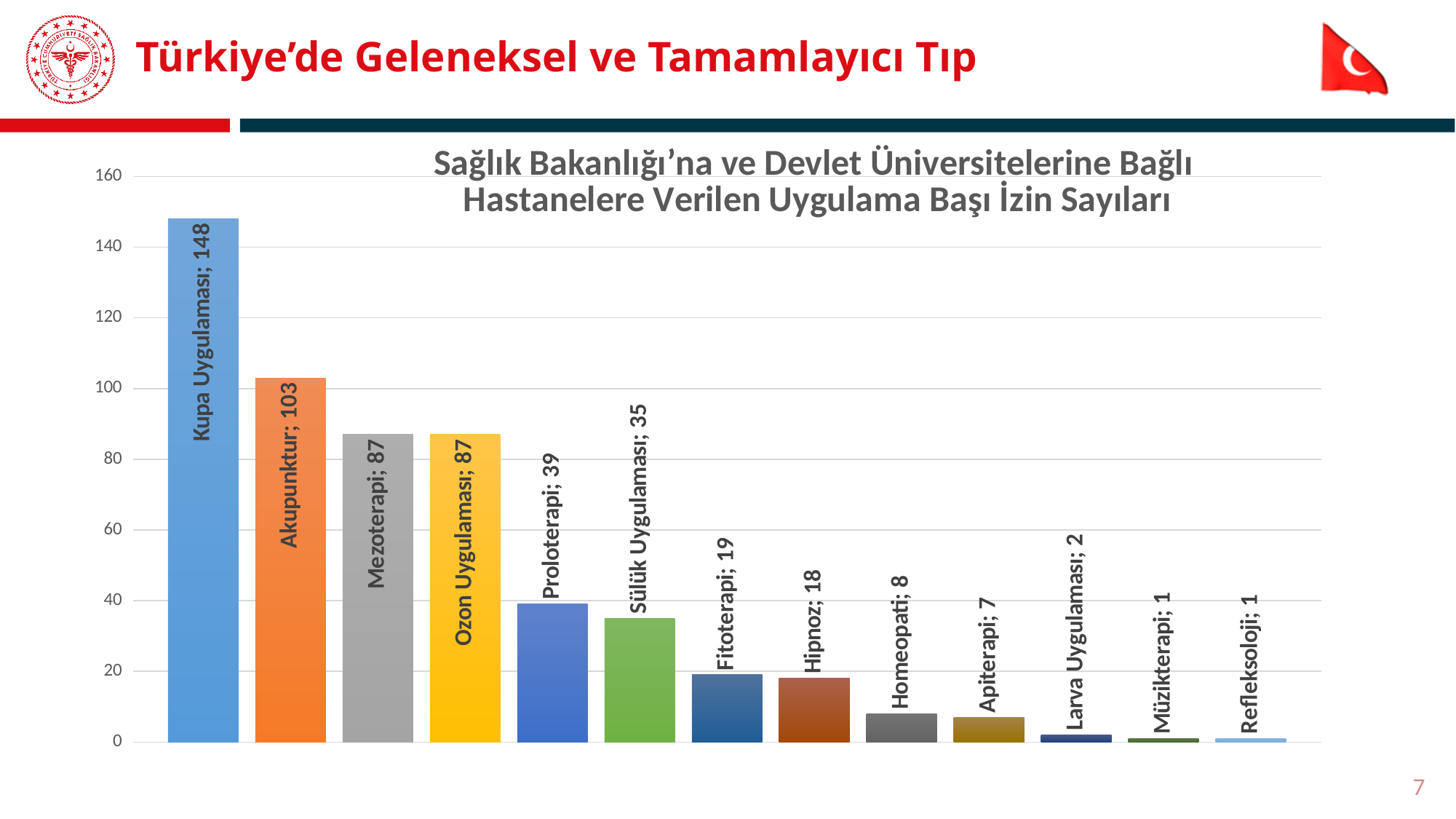
What is the difference between the values for Kupa Uygulaması and Akupunktur? 45 What is the value for Homeopati? 8 Which is larger, the value for Fitoterapi or the value for Hipnoz? Fitoterapi What is the difference between the values for Proloterapi and Sülük Uygulaması? 4 What is the value for Sülük Uygulaması? 35 Is the value for Mezoterapi greater or less than 80? greater What is the value for Akupunktur? 103 What is the title of the chart? Sağlık Bakanlığı'na ve Devlet Üniversitelerine Bağlı Hastanelere Verilen Uygulama Başı İzin Sayıları What kind of chart is shown on the slide? Bar chart What is the value for Larva Uygulaması? 2 How many categories are shown in the chart? 13 Which category has the highest value? Kupa Uygulaması